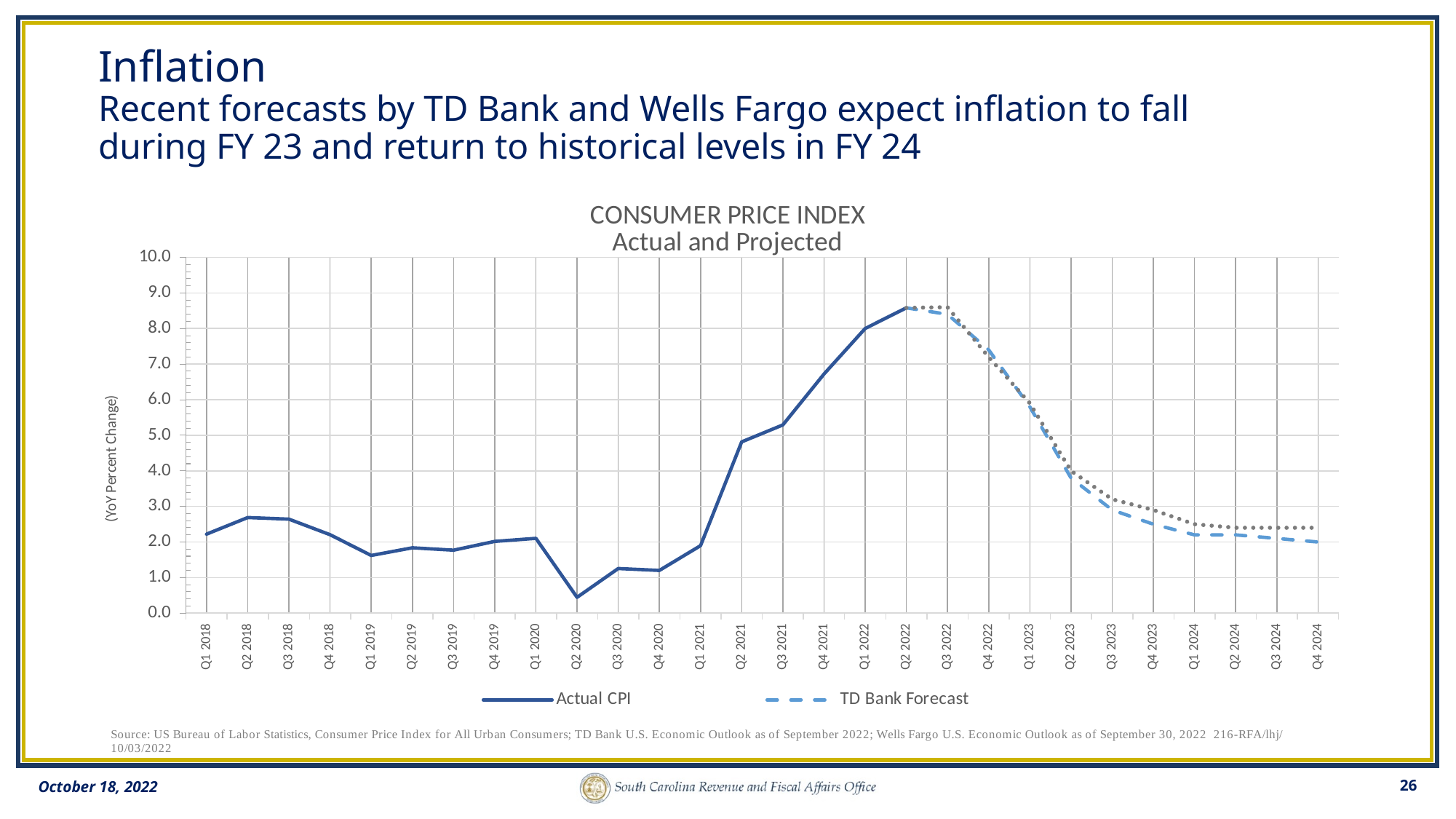
Does the Actual CPI line rise or fall from Q2 2020 to Q2 2022? rise Is the Actual CPI value for Q2 2020 greater or less than 1.0? less How many quarters are shown along the x axis of the chart? 28 How many series does the chart legend list? 2 Does the TD Bank Forecast line rise or fall from Q2 2022 to Q4 2024? fall Is the TD Bank Forecast value for Q1 2023 greater or less than 5.0? greater In which quarter does the Actual CPI line reach its highest value? Q2 2022 Which is larger, the Actual CPI value for Q2 2018 or for Q1 2019? Q2 2018 In which quarter does the Actual CPI line reach its lowest value? Q2 2020 What is the label on the chart's vertical axis? (YoY Percent Change) Is the Actual CPI value for Q2 2022 greater or less than 8.0? greater What kind of chart is shown on the slide? line chart